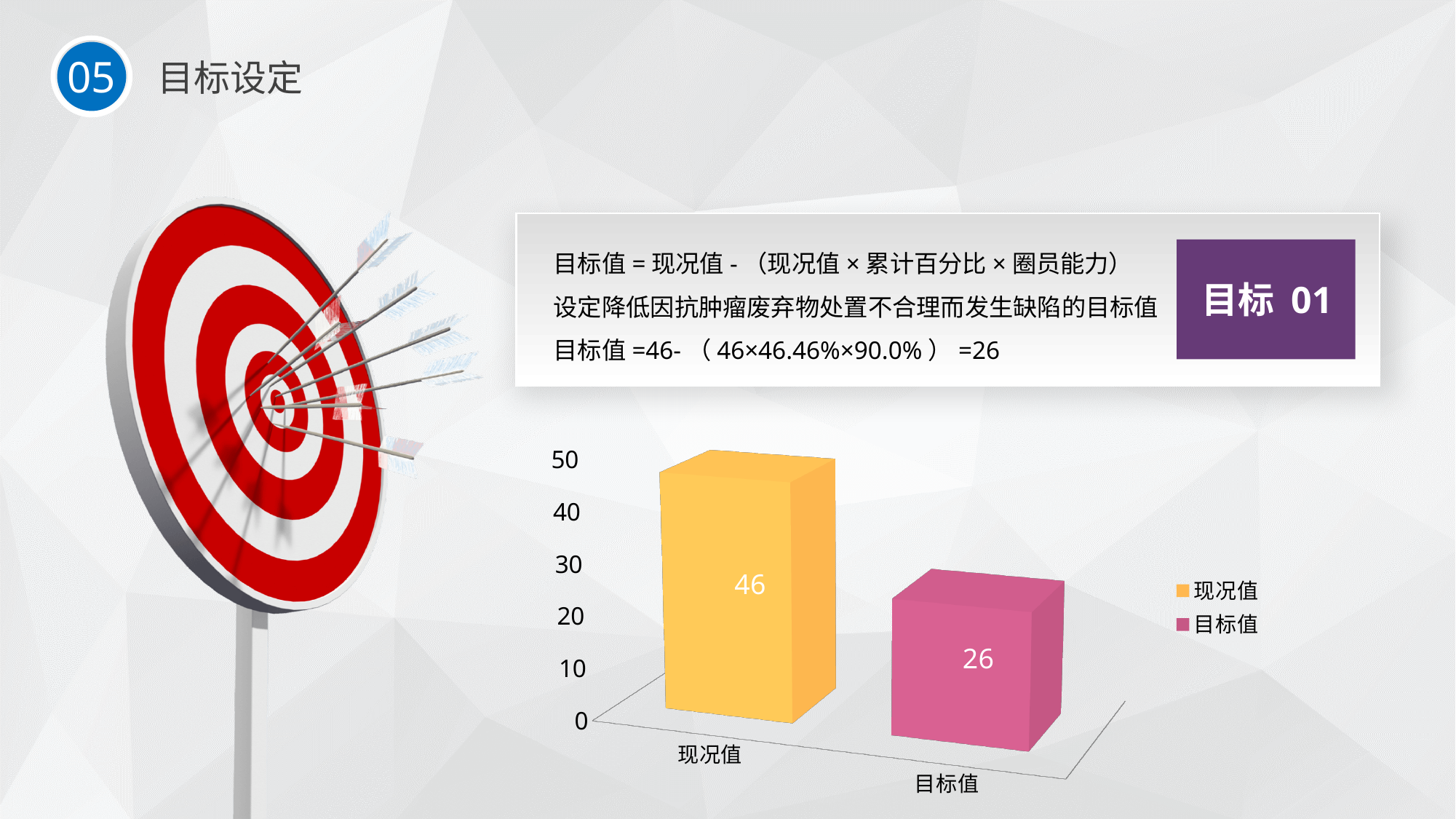
Is the value for 目标值 greater or less than 30? less What colour is the bar for 目标值? pink What is the difference between the values for 现况值 and 目标值? 20 How many series does the legend list? 2 How many categories are shown on the chart? 2 What kind of chart is shown on the slide? bar chart Is the value for 现况值 greater or less than 40? greater Which is larger, the value for 现况值 or the value for 目标值? 现况值 Which category has the lowest value? 目标值 What is the value for 目标值? 26 Which category has the highest value? 现况值 What is the value for 现况值? 46